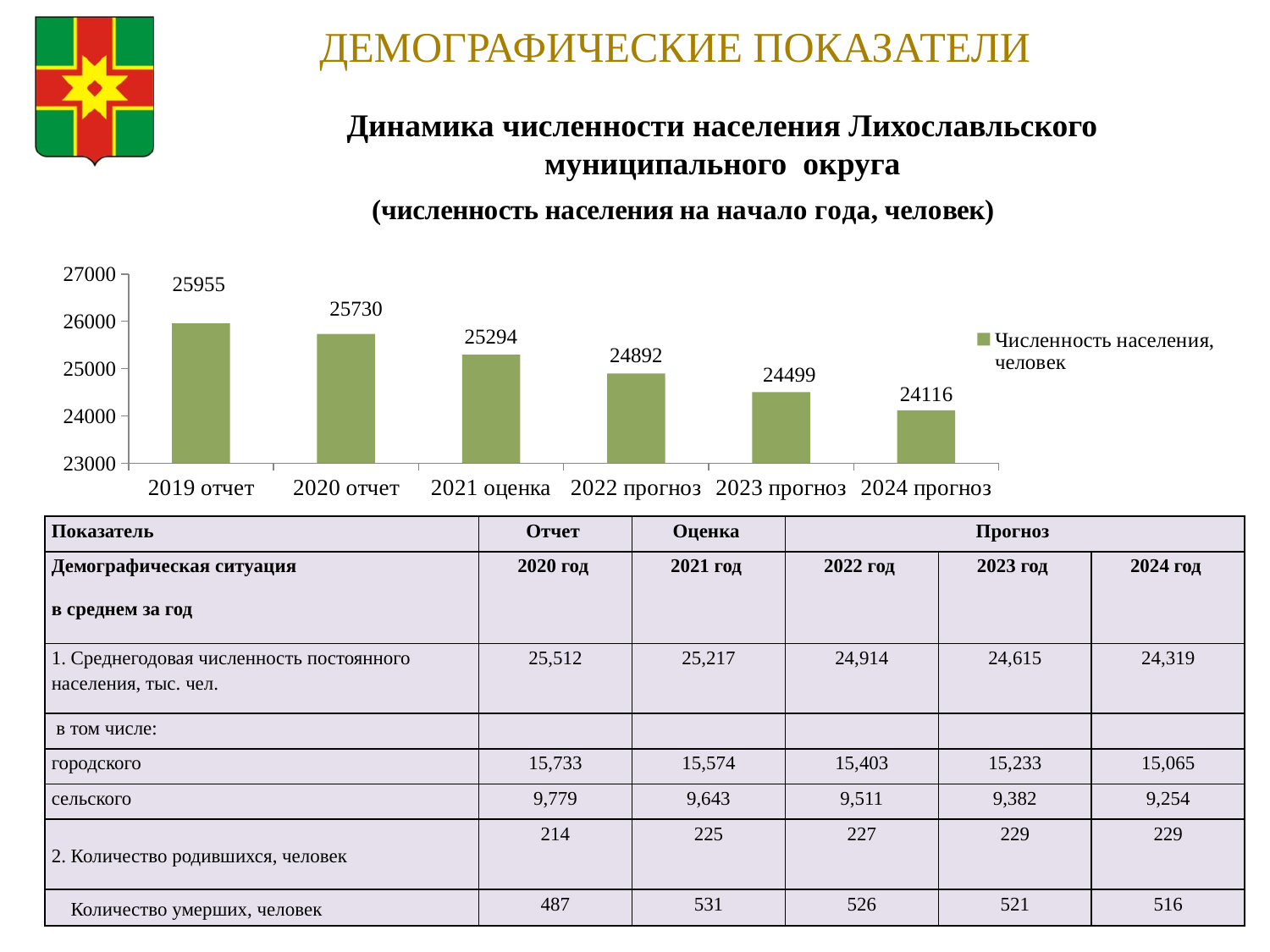
What is the difference between the population values for 2021 оценка and 2024 прогноз? 1178 What is the population value shown for 2024 прогноз? 24116 What is the population value shown for 2019 отчет? 25955 What is the difference between the population values for 2019 отчет and 2020 отчет? 225 Which category has the lowest population value? 2024 прогноз What kind of chart is shown on the slide? bar chart Do the population values rise or fall from 2019 to 2024 along the x axis? fall Is the value for 2023 прогноз greater or less than 25000? less What is the population value shown for 2022 прогноз? 24892 Which is larger, the population value for 2021 оценка or for 2023 прогноз? 2021 оценка How many categories are shown on the x axis of the chart? 6 Which category has the highest population value? 2019 отчет